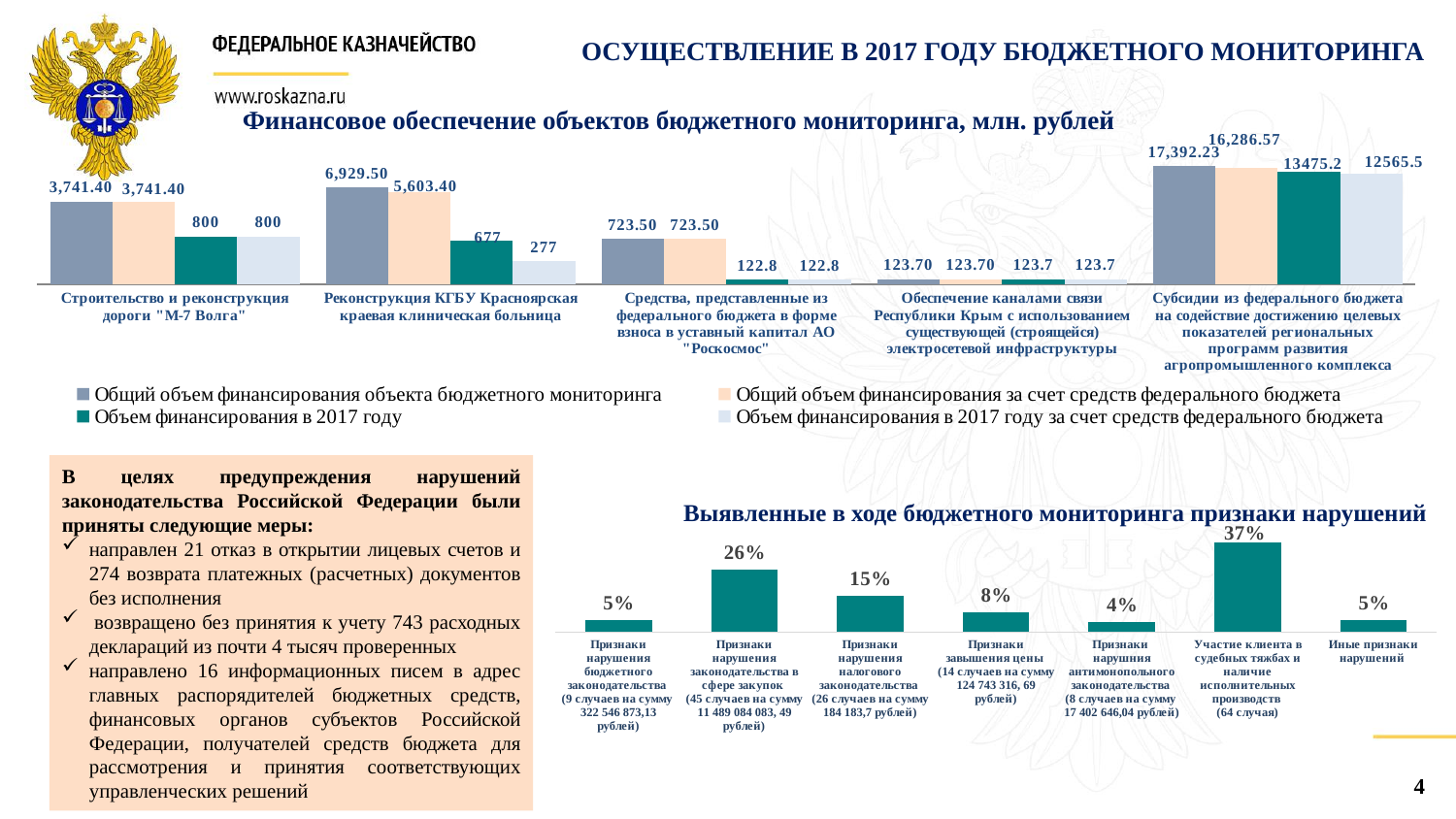
In the chart "Финансовое обеспечение объектов бюджетного мониторинга, млн. рублей", what is the value of "Объем финансирования в 2017 году" for the АО "Роскосмос" category? 122.8 In the chart "Финансовое обеспечение объектов бюджетного мониторинга, млн. рублей", which is larger for "Объем финансирования в 2017 году": "Строительство и реконструкция дороги "М-7 Волга"" or "Реконструкция КГБУ Красноярская краевая клиническая больница"? Строительство и реконструкция дороги "М-7 Волга" In the chart "Выявленные в ходе бюджетного мониторинга признаки нарушений", what is the value for "Признаки нарушения законодательства в сфере закупок"? 26% In the chart "Финансовое обеспечение объектов бюджетного мониторинга, млн. рублей", what is the value of "Объем финансирования в 2017 году за счет средств федерального бюджета" for the "Субсидии из федерального бюджета..." category? 12565.5 In the chart "Выявленные в ходе бюджетного мониторинга признаки нарушений", which category has the lowest value? Признаки нарушения антимонопольного законодательства How many series does the legend of the chart "Финансовое обеспечение объектов бюджетного мониторинга, млн. рублей" list? 4 In the chart "Выявленные в ходе бюджетного мониторинга признаки нарушений", which category has the highest value? Участие клиента в судебных тяжбах и наличие исполнительных производств In the chart "Финансовое обеспечение объектов бюджетного мониторинга, млн. рублей", which category has the highest value of "Общий объем финансирования объекта бюджетного мониторинга"? Субсидии из федерального бюджета на содействие достижению целевых показателей региональных программ развития агропромышленного комплекса In the chart "Финансовое обеспечение объектов бюджетного мониторинга, млн. рублей", what is the value of "Общий объем финансирования объекта бюджетного мониторинга" for "Реконструкция КГБУ Красноярская краевая клиническая больница"? 6,929.50 In the chart "Финансовое обеспечение объектов бюджетного мониторинга, млн. рублей", what is the difference between "Общий объем финансирования объекта бюджетного мониторинга" and "Общий объем финансирования за счет средств федерального бюджета" for "Реконструкция КГБУ Красноярская краевая клиническая больница"? 1,326.10 What type of chart is "Выявленные в ходе бюджетного мониторинга признаки нарушений"? Bar chart How many categories are shown in the chart "Выявленные в ходе бюджетного мониторинга признаки нарушений"? 7